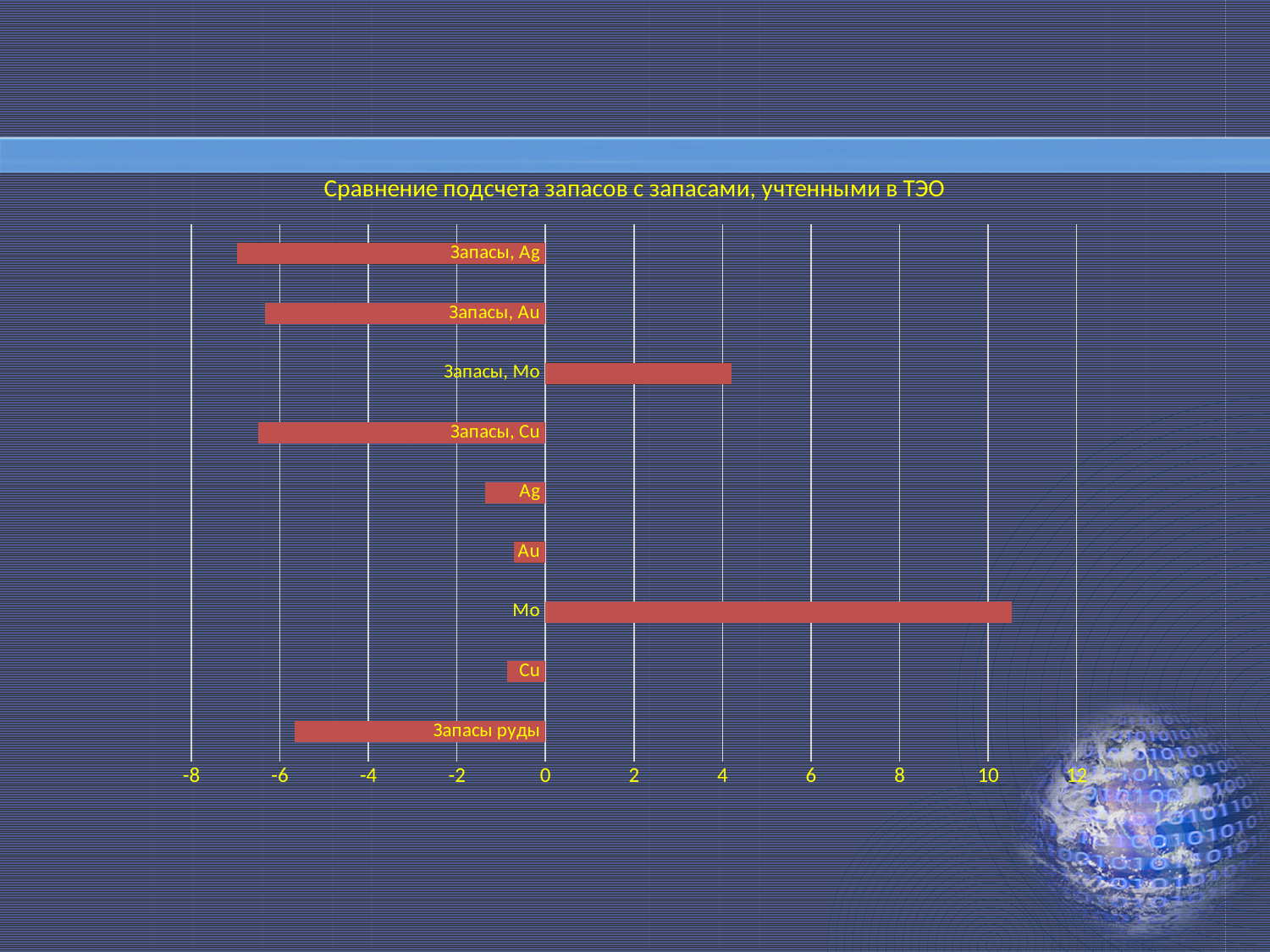
Is the value for Mo greater or less than 8? greater Is the value for Запасы, Ag greater or less than -6? less How many categories (bars) does the chart show? 9 What kind of chart is shown on the slide? bar chart Is the value for Запасы руды greater or less than -4? less Which category has the highest value? Mo Which is larger, the value for Mo or the value for Запасы, Mo? Mo What is the title of the chart? Сравнение подсчета запасов с запасами, учтенными в ТЭО Which category has the lowest value? Запасы, Ag How many bars extend to the right of 0 (positive values)? 2